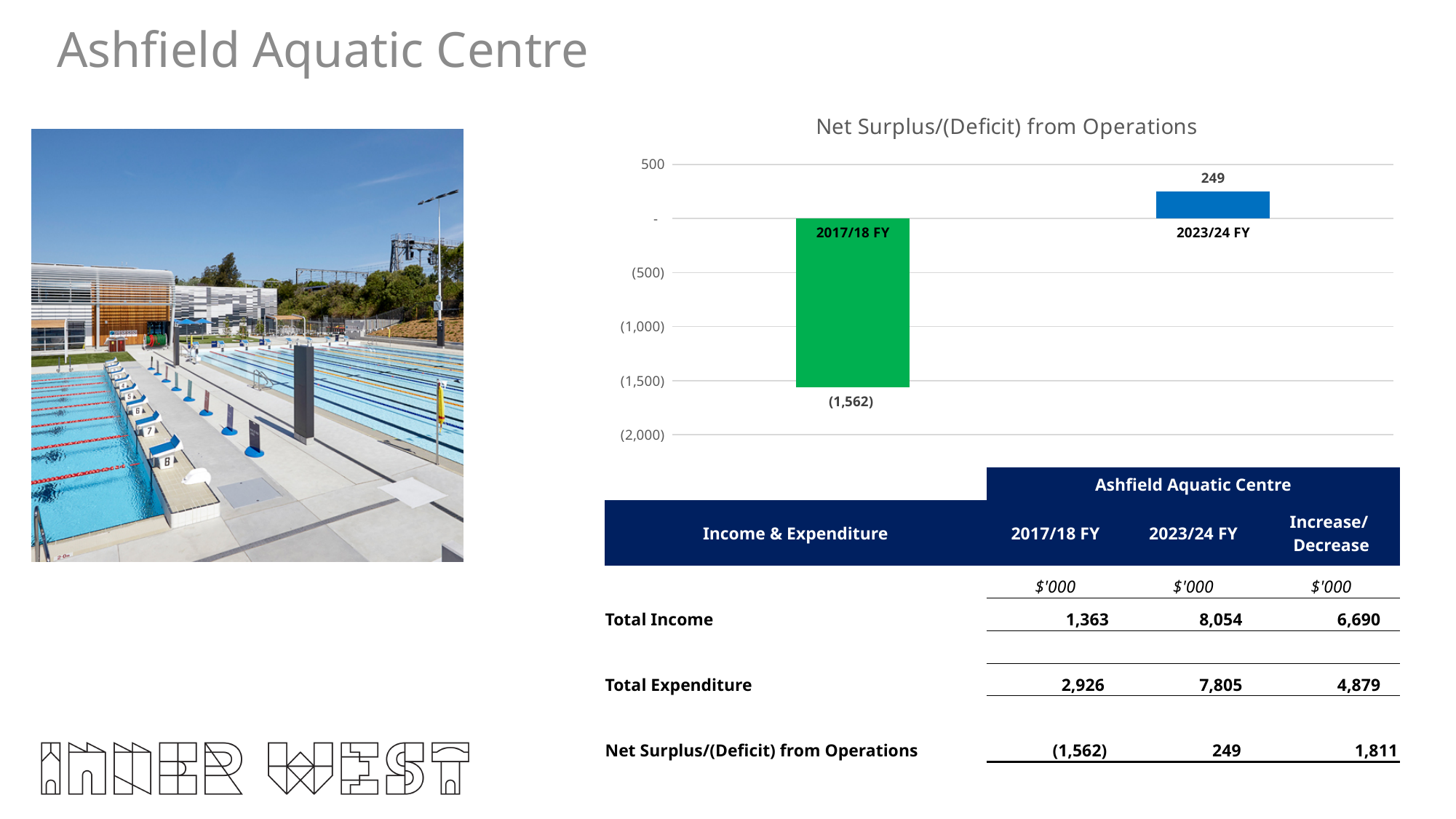
What colour is the bar for 2017/18 FY in the chart? Green What kind of chart is used to show Net Surplus/(Deficit) from Operations? Bar chart Is the value for 2023/24 FY in the chart greater or less than 500? less How many financial years are plotted in the Net Surplus/(Deficit) from Operations chart? 2 What is the value for 2017/18 FY in the Net Surplus/(Deficit) from Operations chart? (1,562) What is the title of the chart on the slide? Net Surplus/(Deficit) from Operations What is the difference between the 2023/24 FY and 2017/18 FY values in the chart? 1,811 Which financial year has the lowest value in the Net Surplus/(Deficit) from Operations chart? 2017/18 FY Do the values in the Net Surplus/(Deficit) from Operations chart rise or fall from 2017/18 FY to 2023/24 FY? Rise Which financial year has the higher net surplus/(deficit) in the chart? 2023/24 FY What is the value for 2023/24 FY in the Net Surplus/(Deficit) from Operations chart? 249 Is the value for 2017/18 FY in the chart greater or less than (1,500)? less